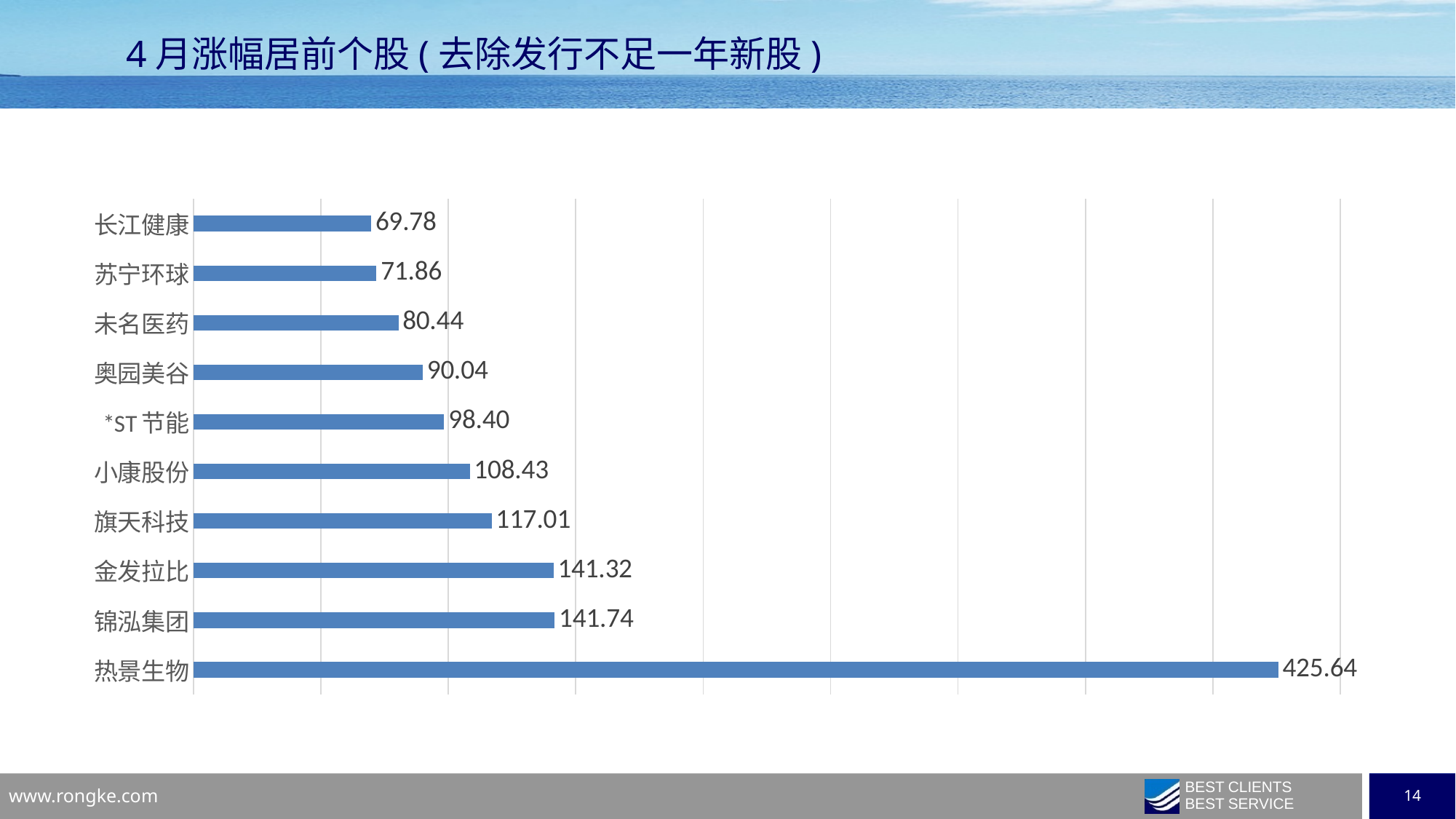
What is the value shown for 奥园美谷? 90.04 Which stock has the lowest value in the chart? 长江健康 What is the value shown for *ST节能? 98.40 How many stocks are shown in the chart? 10 What is the value shown for 小康股份? 108.43 Which stock has the highest value in the chart? 热景生物 What is the difference between the values for 小康股份 and *ST节能? 10.03 What is the value shown for 热景生物? 425.64 What type of chart is shown on the slide? bar chart What is the title of the slide? 4月涨幅居前个股(去除发行不足一年新股) What is the difference between the values for 热景生物 and 锦泓集团? 283.90 Which has a larger value, 旗天科技 or 未名医药? 旗天科技